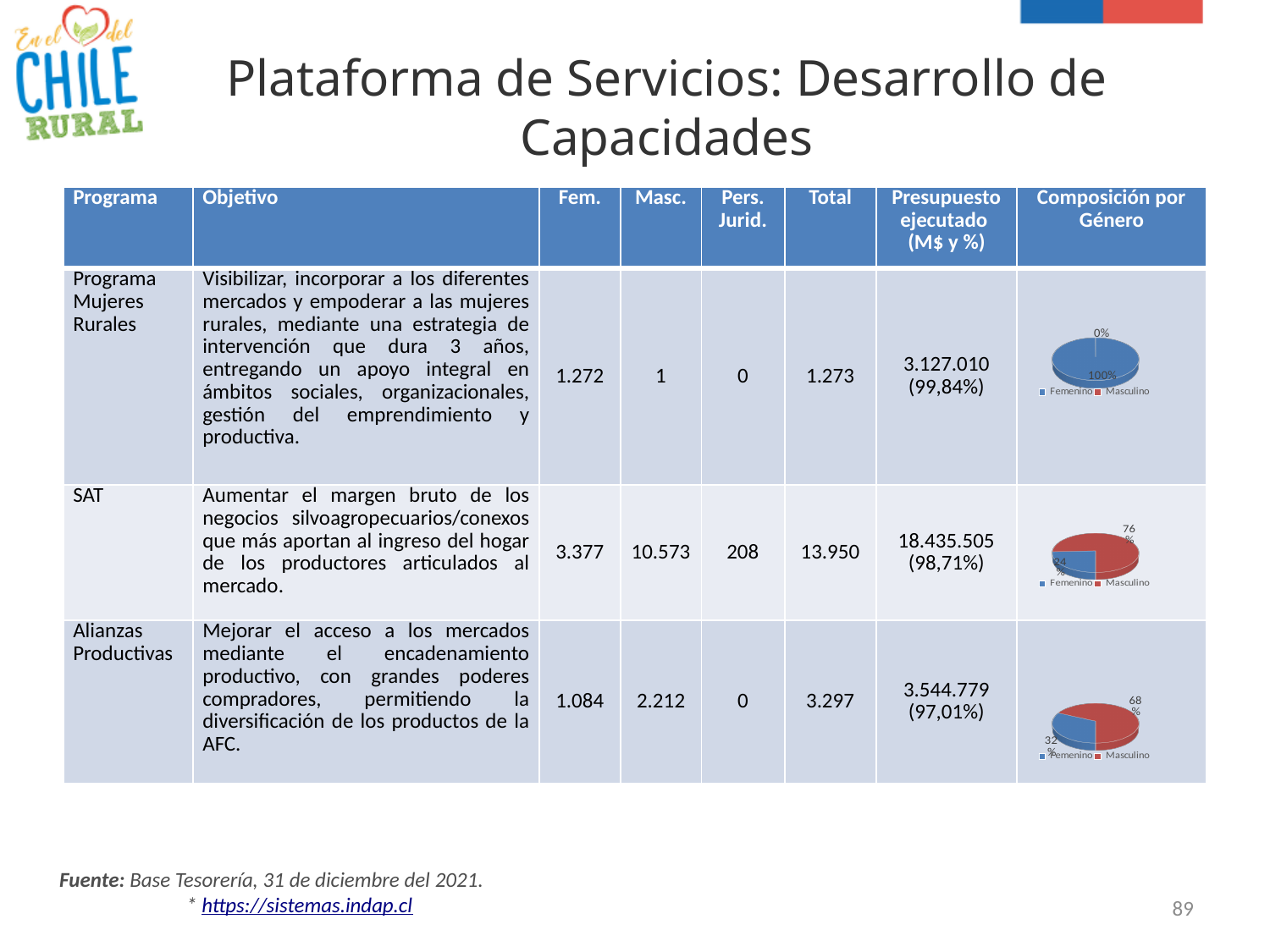
How many pie charts are shown in the Composición por Género column? 3 In the pie chart for the Alianzas Productivas row, what share is labelled for Masculino? 68% In the pie chart for the Programa Mujeres Rurales row, what share is labelled for Femenino? 100% In the pie chart for the SAT row, which slice is larger, Femenino or Masculino? Masculino In the pie chart for the SAT row, what share is labelled for Femenino? 24% How many entries does the legend list in each Composición por Género pie chart? 2 In the pie chart for the SAT row, what is the difference between the Masculino and Femenino shares? 52% What kind of chart is shown in the Composición por Género column for each programme? pie chart In the pie chart for the Alianzas Productivas row, which slice is the largest? Masculino